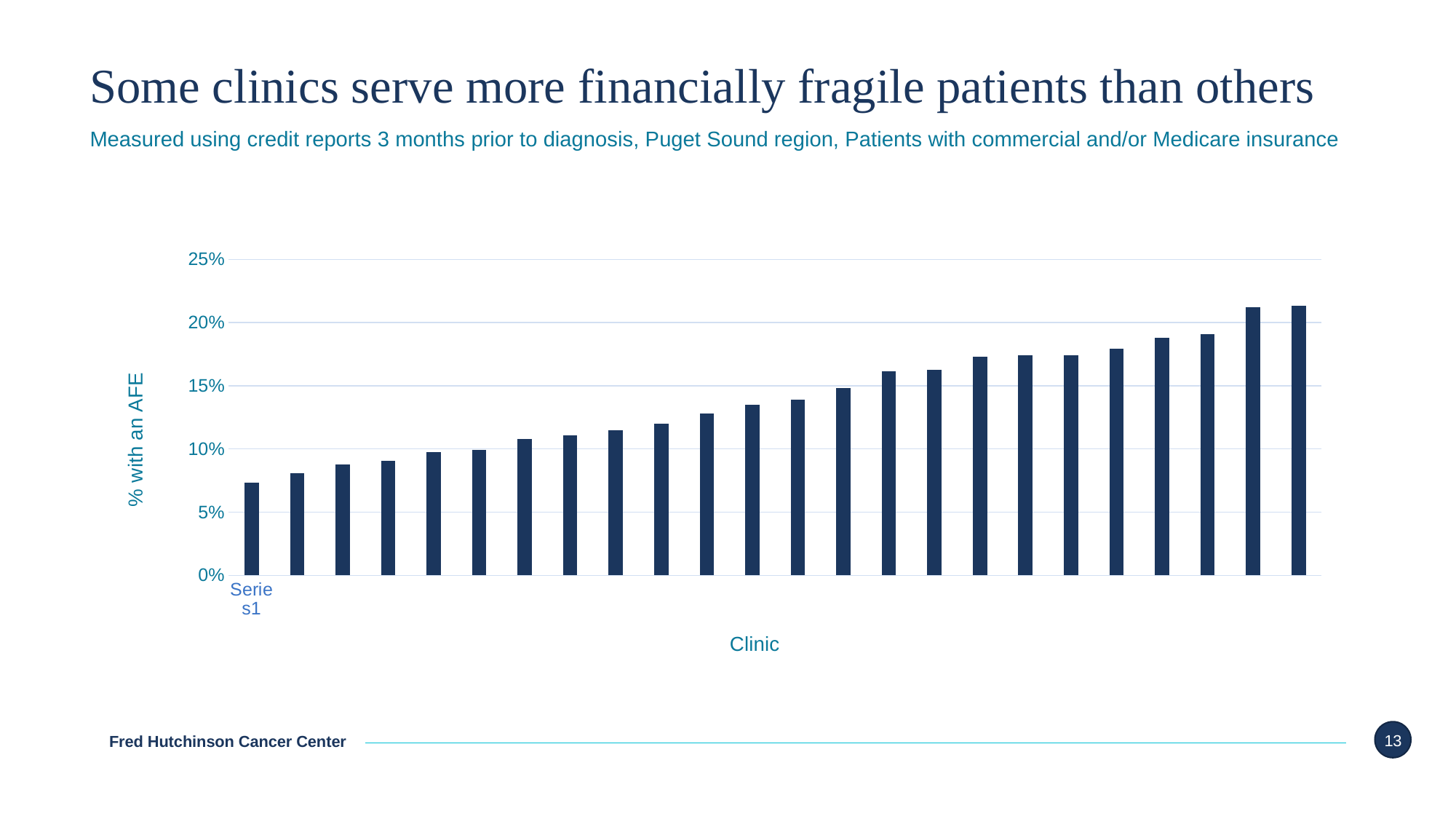
What is the title of the horizontal axis? Clinic Is the value for the bar labelled Series1 greater or less than 10%? less Which bar has the lowest value, the leftmost or the rightmost? The leftmost How many bars (clinics) are plotted in the chart? 24 Which bar has the highest value, the leftmost or the rightmost? The rightmost Is the value of the rightmost bar greater or less than 25%? less What is the title of the vertical axis? % with an AFE Do the bar values rise or fall from left to right along the x axis? Rise Is the value for the bar labelled Series1 greater or less than 5%? greater Which is larger, the value of the leftmost bar or the value of the rightmost bar? The rightmost bar What kind of chart is shown on the slide? Bar chart